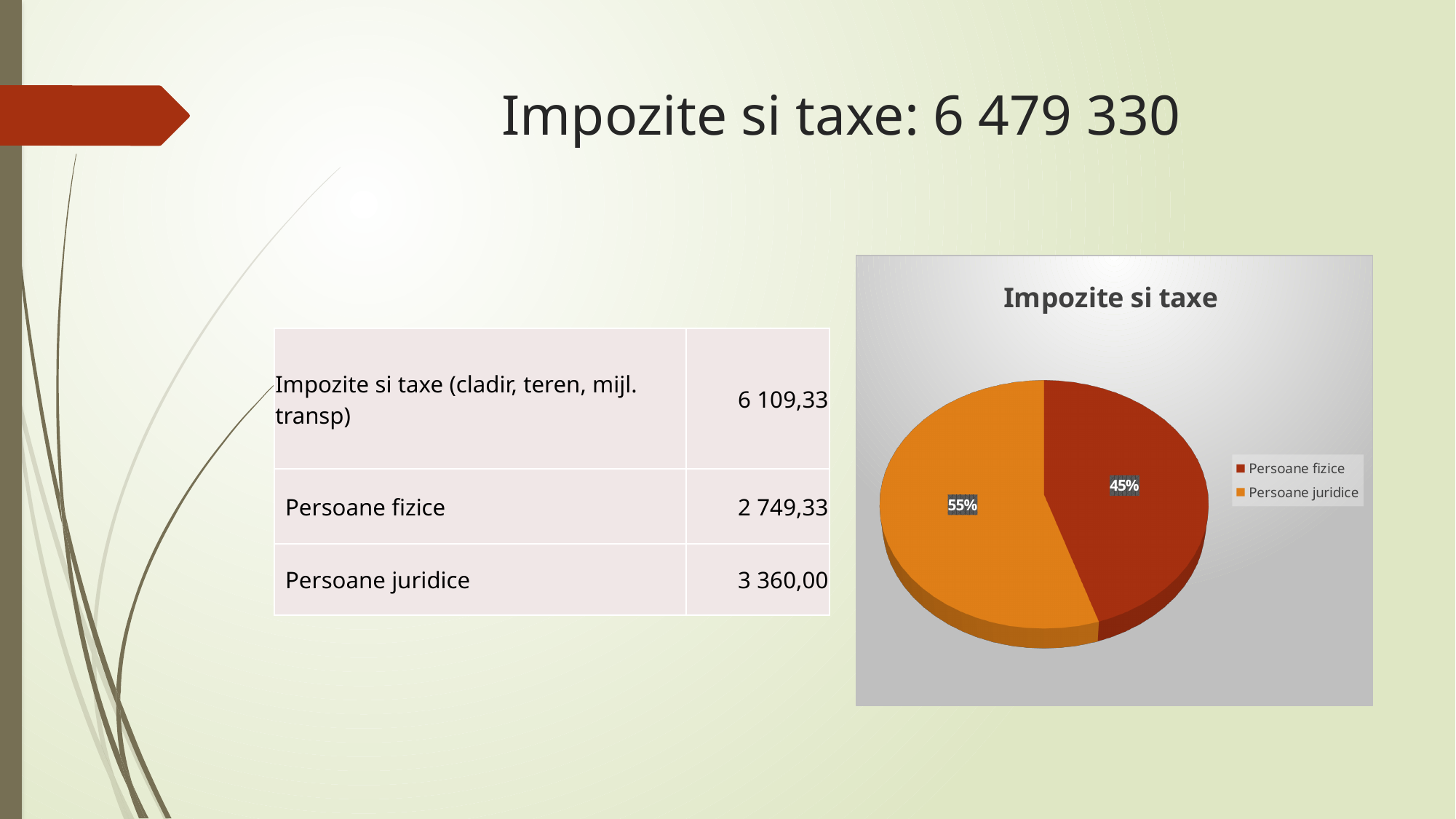
How many slices does the pie chart have? 2 What share of the pie does Persoane juridice represent? 55% Which slice of the pie is the largest? Persoane juridice What share of the pie does Persoane fizice represent? 45% What is the difference in percentage points between the Persoane juridice share and the Persoane fizice share? 10 percentage points Which slice of the pie is the smallest? Persoane fizice What kind of chart is shown on the slide? pie chart Which legend entry is shown in orange? Persoane juridice How many entries does the legend list? 2 Which is larger, the share for Persoane fizice or the share for Persoane juridice? Persoane juridice Is the share for Persoane fizice greater or less than 50%? less What is the title of the chart? Impozite si taxe